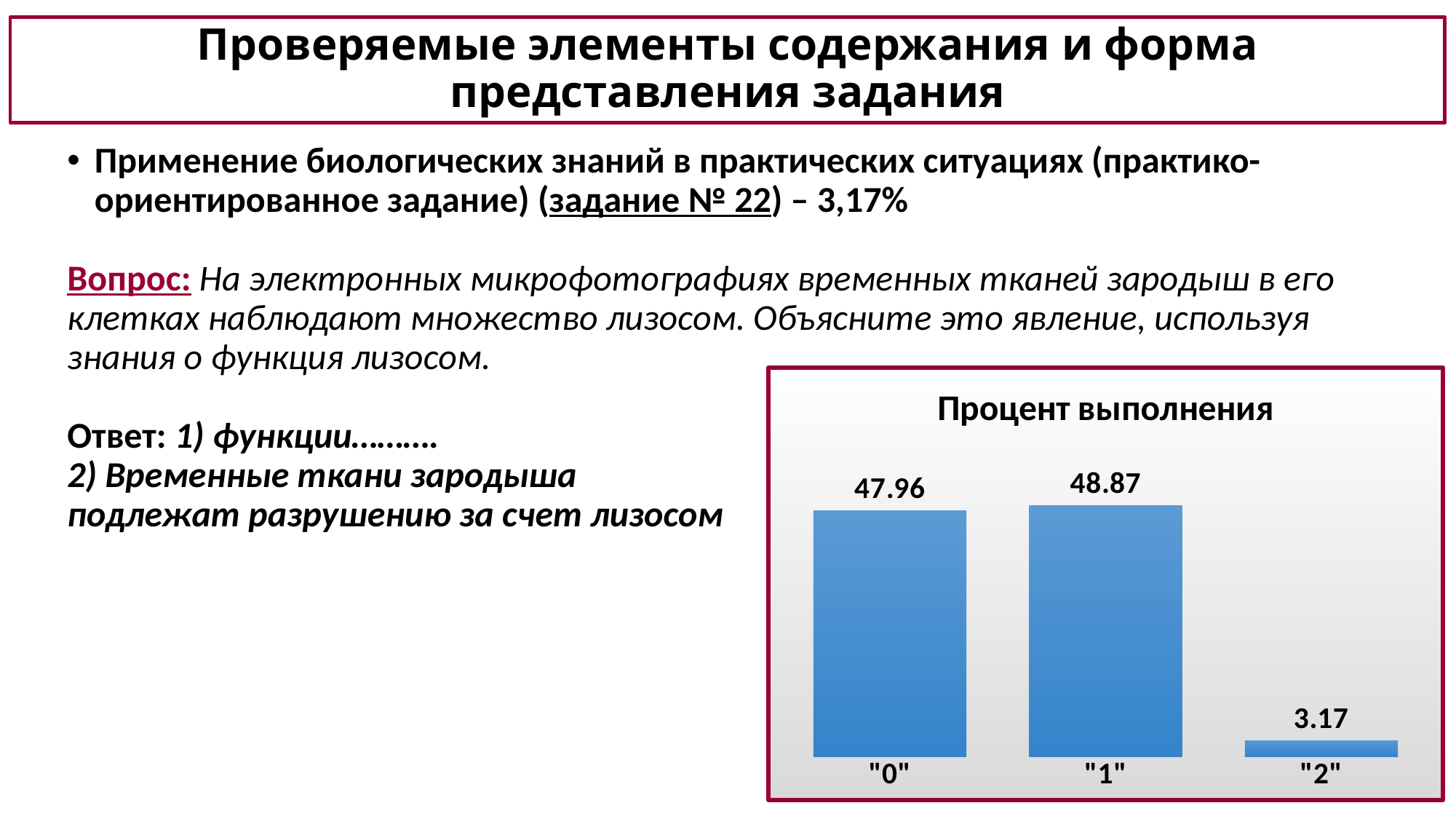
What is the title of the chart? Процент выполнения Which is larger, the value for "0" or the value for "2"? "0" What is the value for category "1" in the chart? 48.87 How many categories are shown in the chart? 3 What colour are the bars in the chart? Blue What kind of chart is shown on the slide? Bar chart What is the value for category "0" in the chart? 47.96 What is the value for category "2" in the chart? 3.17 What is the difference between the values for "1" and "0"? 0.91 What is the difference between the values for "0" and "2"? 44.79 Which category has the highest value in the chart? "1" Which category has the lowest value in the chart? "2"